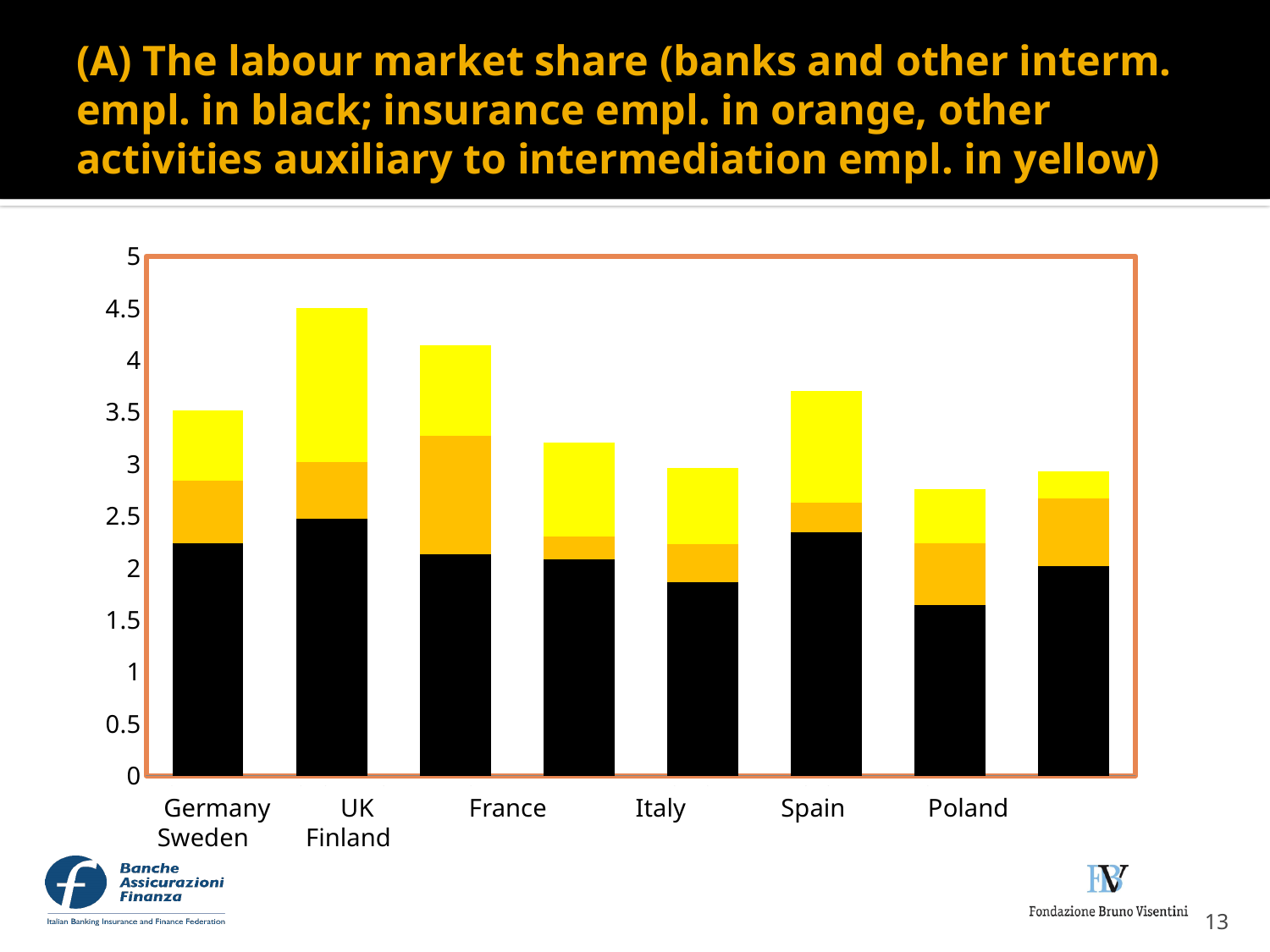
Is the total of the seventh bar from the left greater or less than 3? less Is the total of the second bar from the left greater or less than 4? greater How many bars are plotted in the chart? 8 According to the title, which colour represents insurance employment? Orange Is the black segment of the seventh bar from the left greater or less than 2? less Which bar is the tallest in the chart? The second bar from the left Which is taller, the fifth bar from the left or the sixth bar from the left? The sixth bar from the left According to the title, which colour represents banks and other intermediaries employment? Black What kind of chart is shown on the slide? Stacked bar chart Which is taller, the second bar from the left or the third bar from the left? The second bar from the left How many stacked segments (colours) does each bar contain? 3